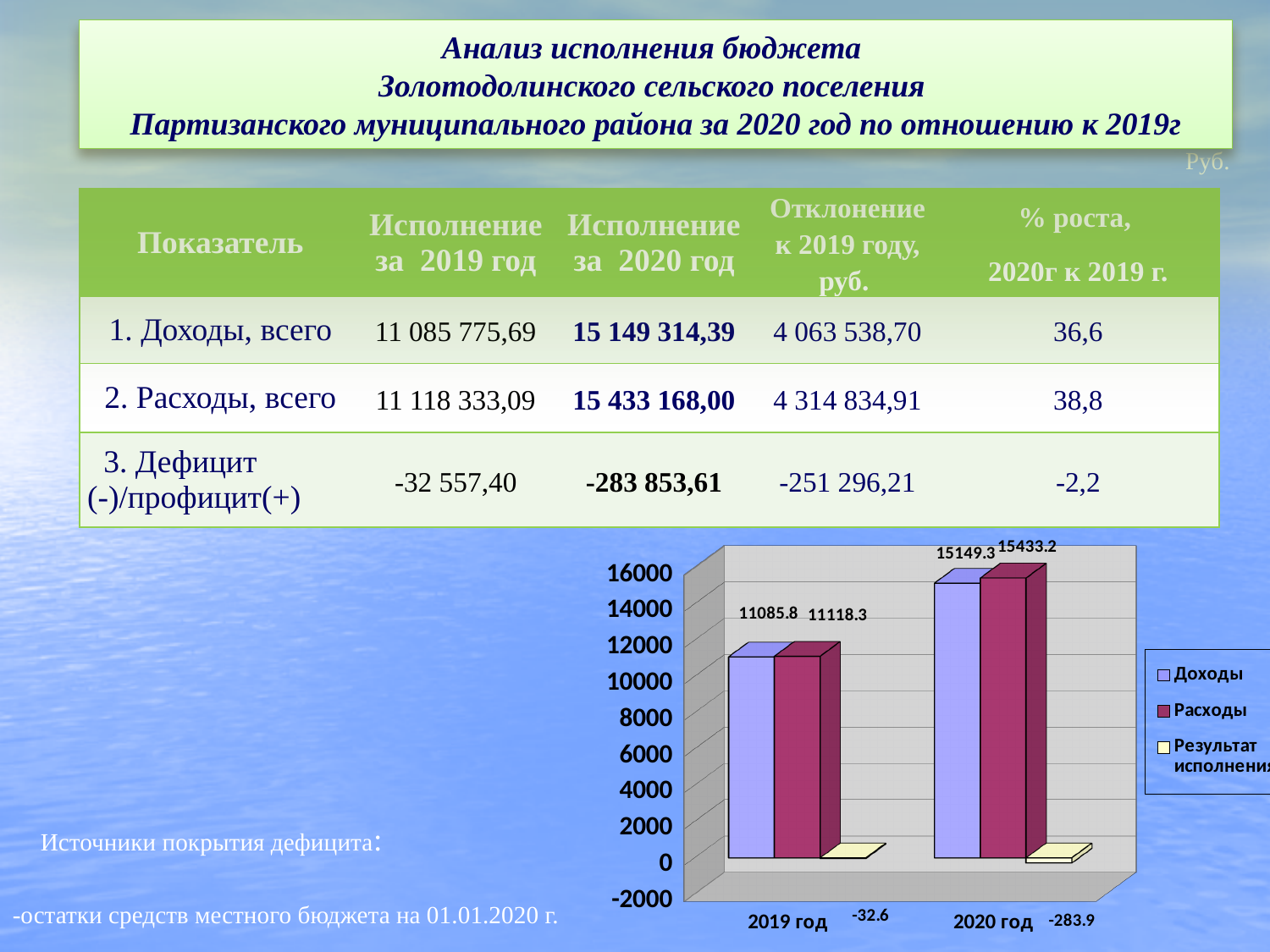
What is the value of Результат исполнения for 2019 год in the chart? -32.6 What is the difference between Расходы for 2020 год and Расходы for 2019 год in the chart? 4314.9 What is the value of Расходы for 2020 год in the chart? 15433.2 How many categories are shown on the x axis of the chart? 2 What type of chart is shown on the slide? bar chart Which year has the higher value for Доходы in the chart? 2020 год What is the value of Доходы for 2019 год in the chart? 11085.8 Is the value of Расходы for 2019 год greater or less than 12000 in the chart? less How many series does the chart legend list? 3 Does the value of Доходы rise or fall from 2019 год to 2020 год in the chart? rise Which series in the chart legend is shown in yellow? Результат исполнения What is the value of Результат исполнения for 2020 год in the chart? -283.9